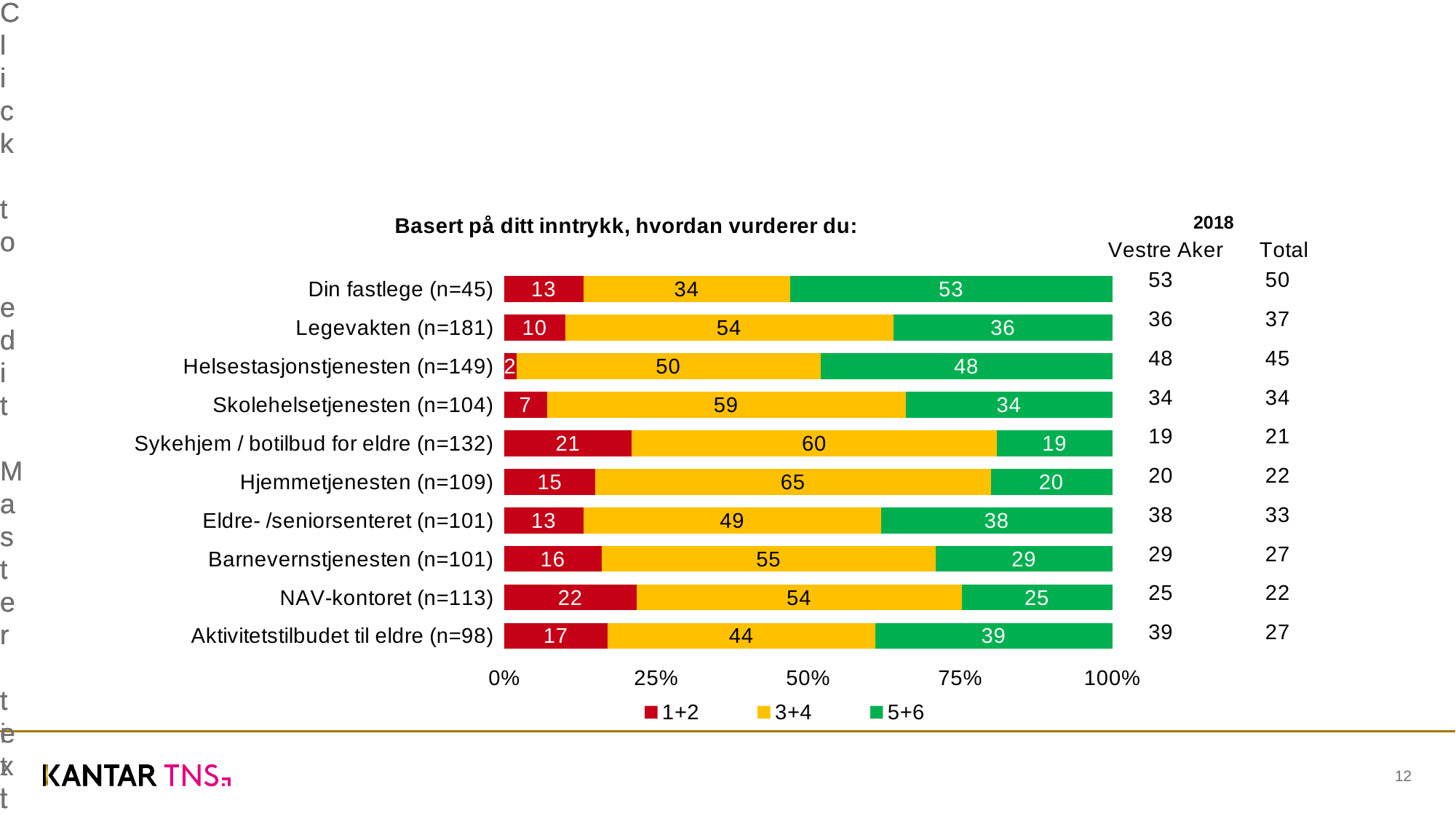
What is the 5+6 value for Din fastlege (n=45)? 53 What is the title of the chart? Basert på ditt inntrykk, hvordan vurderer du: What kind of chart is shown on the slide? Stacked bar chart What is the 3+4 value for Hjemmetjenesten (n=109)? 65 Which category has the highest 5+6 value? Din fastlege (n=45) Which is larger: the 5+6 value for Legevakten (n=181) or for Aktivitetstilbudet til eldre (n=98)? Aktivitetstilbudet til eldre (n=98) What is the total of the stacked bar for Sykehjem / botilbud for eldre (n=132)? 100 How many categories are shown in the chart? 10 What is the 1+2 value for NAV-kontoret (n=113)? 22 Which category has the lowest 1+2 value? Helsestasjonstjenesten (n=149) What is the difference between the 3+4 values for Hjemmetjenesten (n=109) and Din fastlege (n=45)? 31 How many series does the legend list? 3